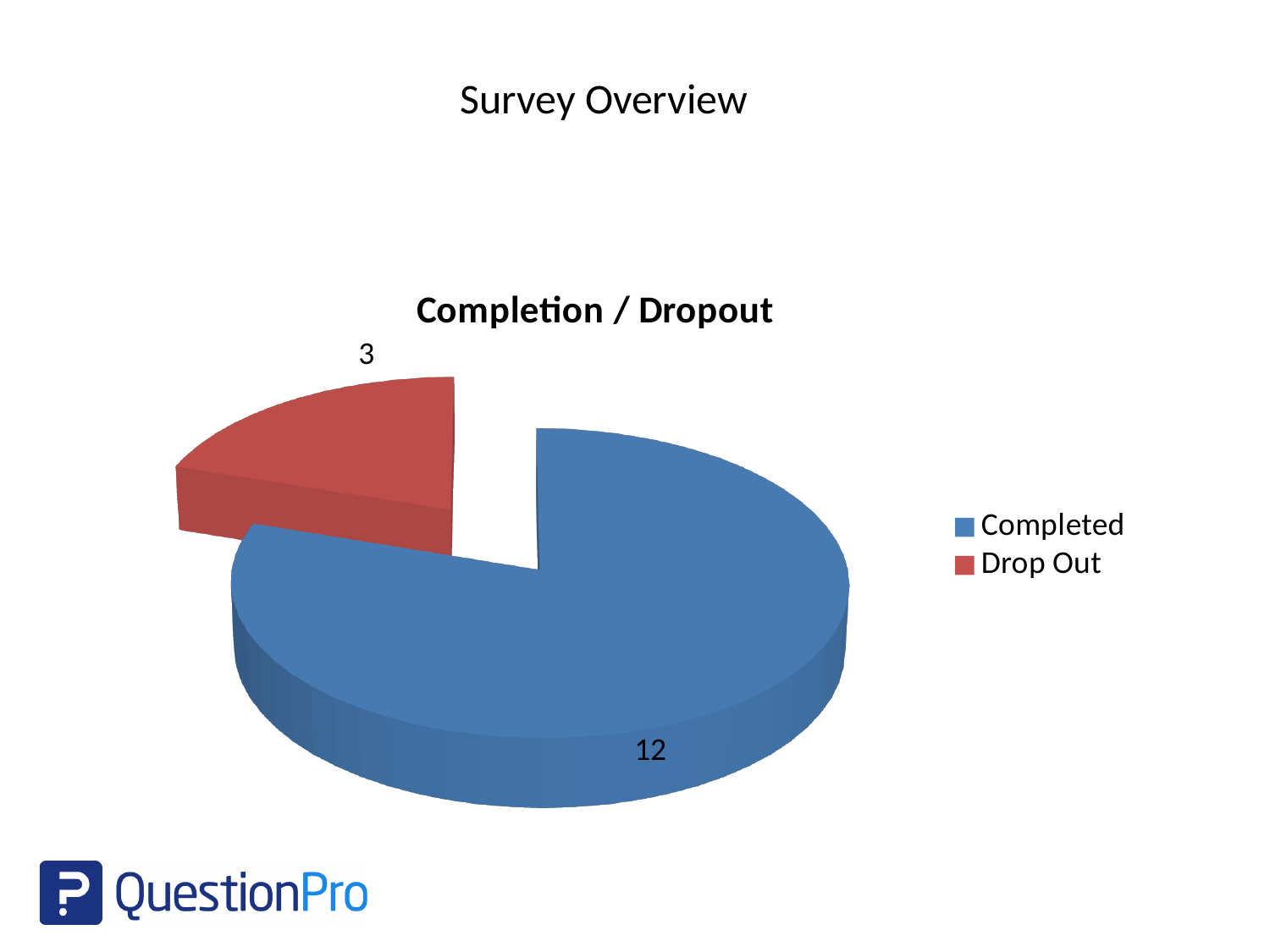
What is the value for Completed? 12 What is the difference between the Completed and Drop Out values? 9 What is the value for Drop Out? 3 What share of the pie does Completed represent? 80% What is the title of the chart? Completion / Dropout What kind of chart is shown? Pie chart Which category has the largest slice? Completed How many entries does the legend list? 2 How many slices does the pie chart have? 2 Which is larger, Completed or Drop Out? Completed Which category has the smallest slice? Drop Out What is the total of all slices in the pie chart? 15